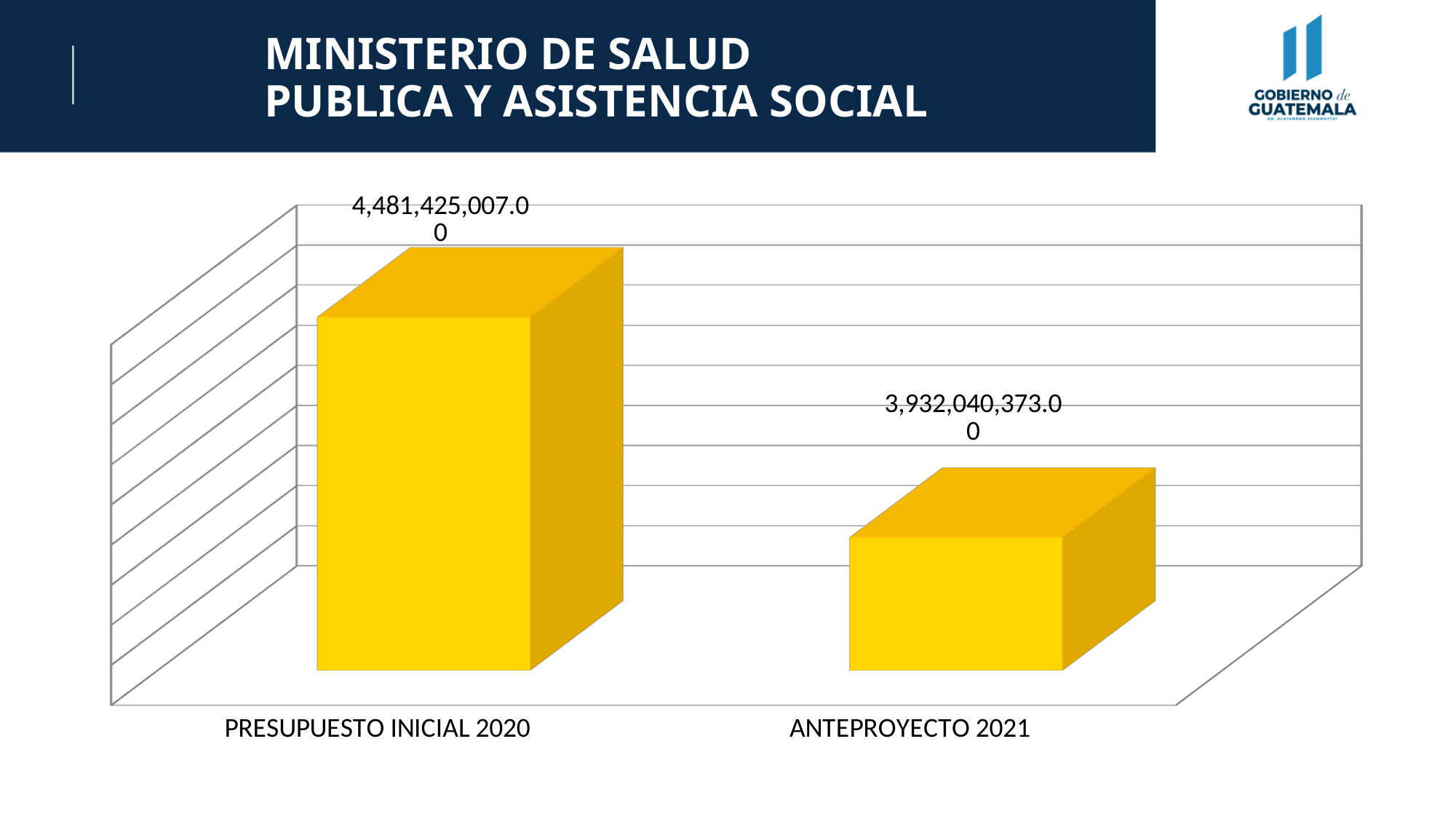
Which category has the highest value? PRESUPUESTO INICIAL 2020 What is the value for ANTEPROYECTO 2021? 3,932,040,373.00 Do the values rise or fall from PRESUPUESTO INICIAL 2020 to ANTEPROYECTO 2021? Fall What is the value for PRESUPUESTO INICIAL 2020? 4,481,425,007.00 How many categories are shown in the chart? 2 What is the difference between the value for PRESUPUESTO INICIAL 2020 and the value for ANTEPROYECTO 2021? 549,384,634.00 Which is larger, the value for PRESUPUESTO INICIAL 2020 or the value for ANTEPROYECTO 2021? PRESUPUESTO INICIAL 2020 What kind of chart is shown on the slide? Bar chart What colour are the bars in the chart? Yellow Which category has the lowest value? ANTEPROYECTO 2021 What is the total of the two values shown in the chart? 8,413,465,380.00 Which ministry is named in the slide title? MINISTERIO DE SALUD PUBLICA Y ASISTENCIA SOCIAL